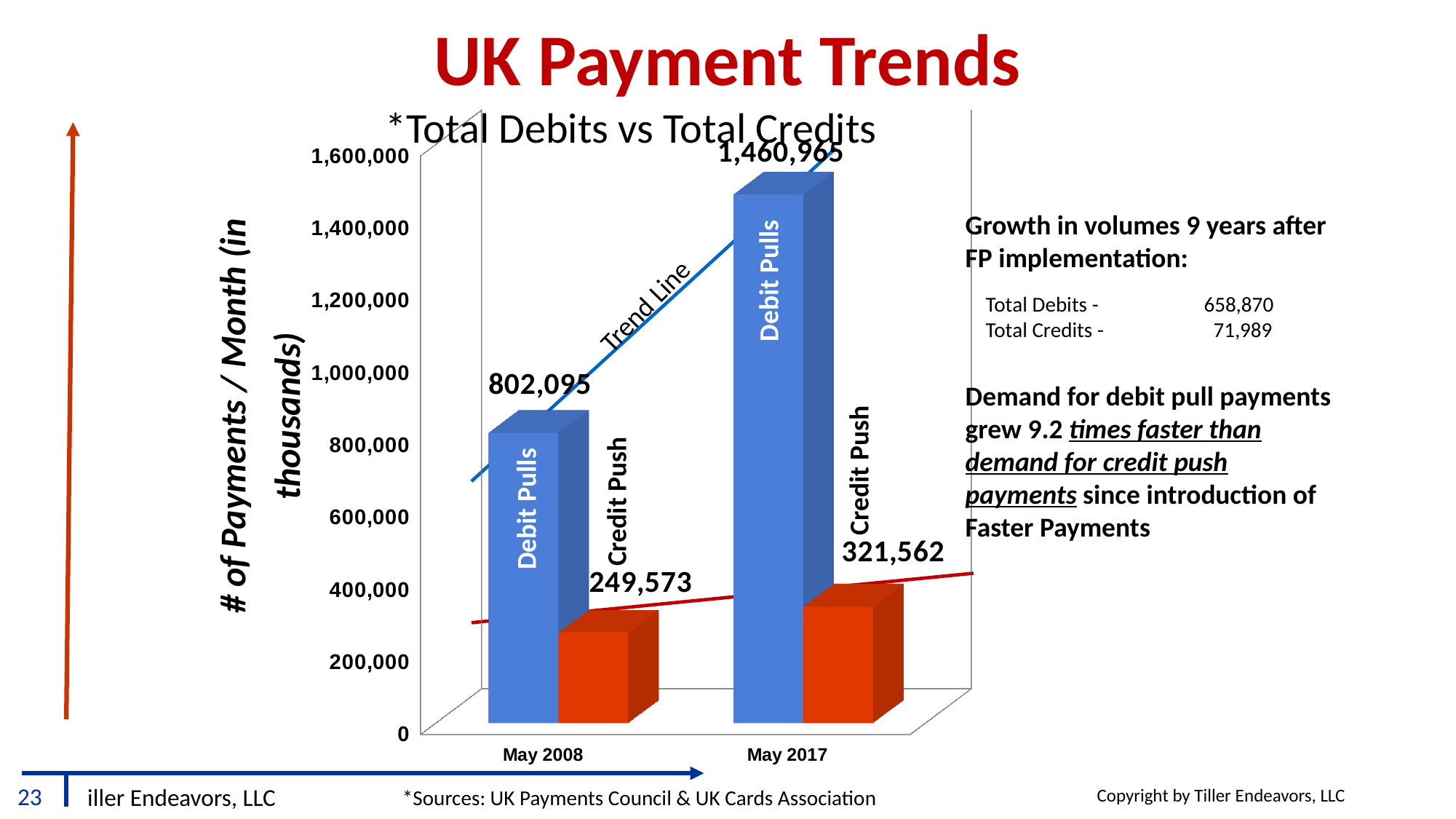
Which bar has the highest value on the chart? Debit Pulls, May 2017 What is the title of the chart? *Total Debits vs Total Credits What is the value of Debit Pulls for May 2017? 1,460,965 By how much did Credit Push increase from May 2008 to May 2017? 71,989 What is the value of Credit Push for May 2008? 249,573 In May 2017, which is larger: Debit Pulls or Credit Push? Debit Pulls Which bar has the lowest value on the chart? Credit Push, May 2008 What is the value of Credit Push for May 2017? 321,562 By how much did Debit Pulls increase from May 2008 to May 2017? 658,870 What is the value of Debit Pulls for May 2008? 802,095 How many time periods are shown on the x axis? 2 What type of chart is shown on the slide? Bar chart